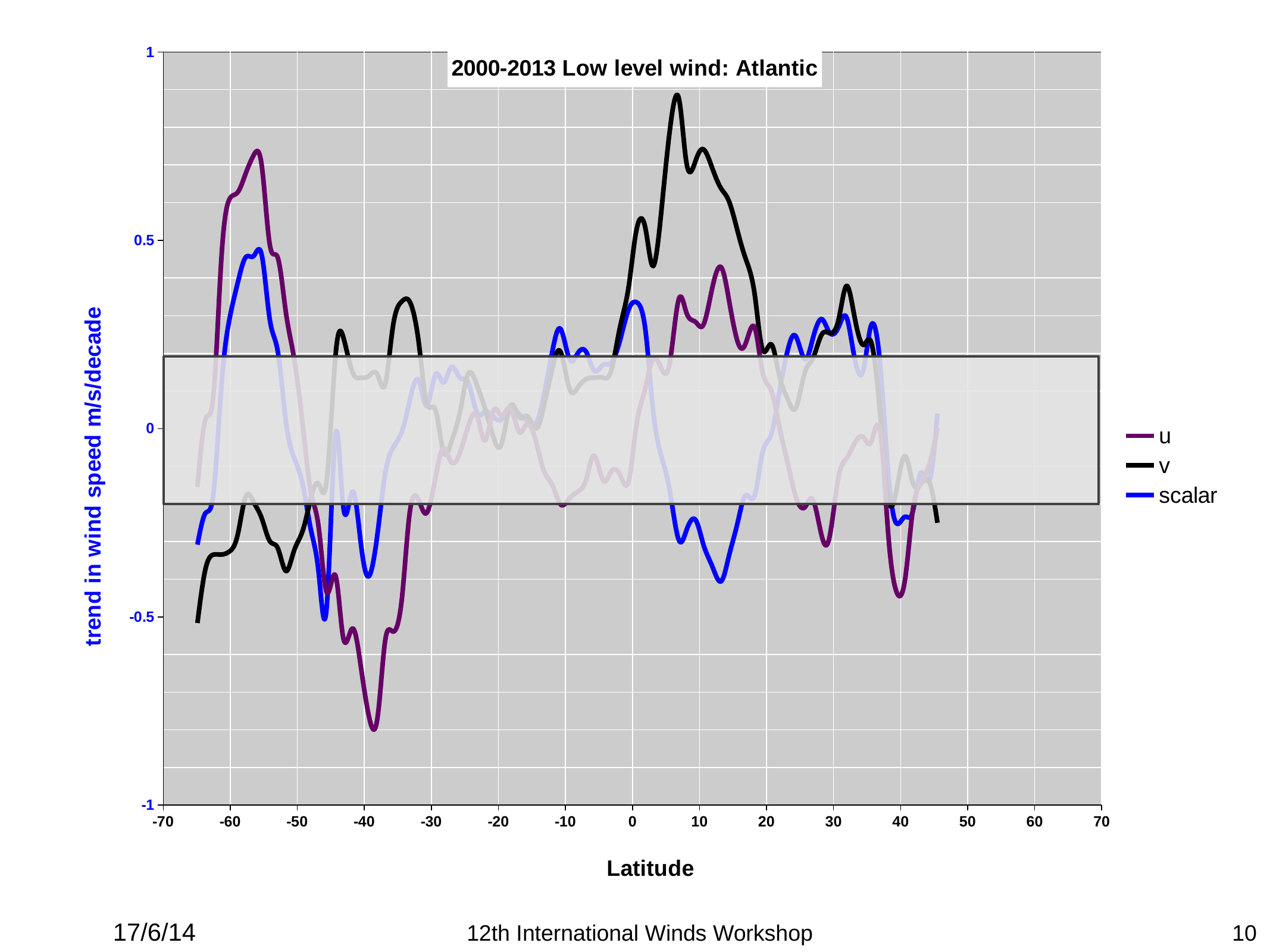
Is the value of the scalar series at latitude 13 greater or less than -0.5? greater How many series does the legend list? 3 What is the label on the vertical axis of the chart? trend in wind speed m/s/decade Is the lowest value of the u series near latitude -39 greater or less than -0.5? less Is the peak value of the v series near latitude 7 greater or less than 0.5? greater Which series reaches the lowest value anywhere on the chart? u Which series reaches the highest value anywhere on the chart? v What is the title of the chart? 2000-2013 Low level wind: Atlantic At latitude 10, which series has the larger value, v or scalar? v What kind of chart is shown on the slide? line chart